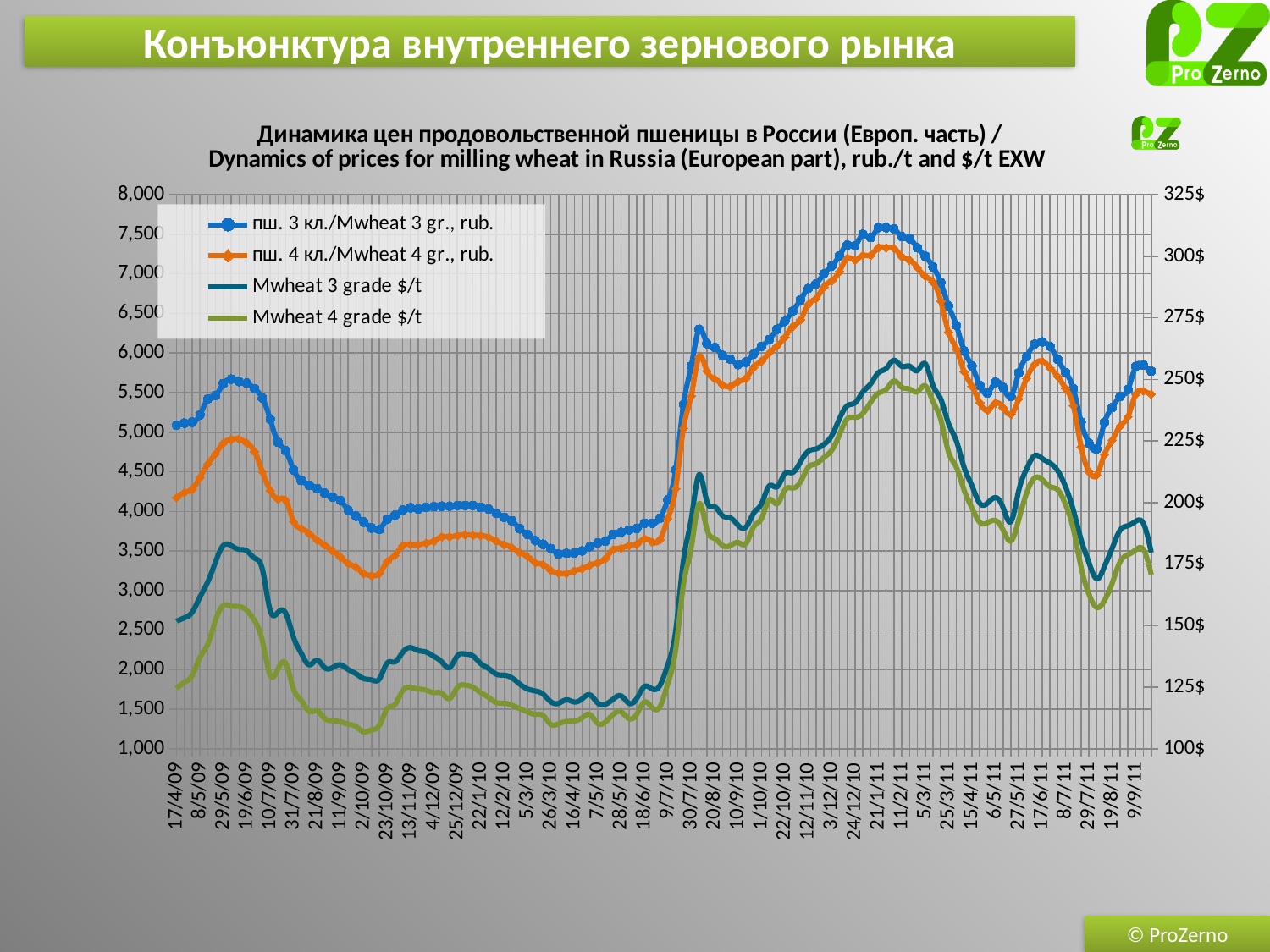
Is the value of Mwheat 4 grade $/t at 2/10/09 greater or less than 125$? less What kind of chart is shown on the slide? line chart Is the value of пш. 3 кл./Mwheat 3 gr., rub. at 2/10/09 greater or less than 4,000? less Is the value of пш. 4 кл./Mwheat 4 gr., rub. at 26/3/10 greater or less than 3,500? less Which series is plotted in blue according to the legend? пш. 3 кл./Mwheat 3 gr., rub. How many series does the legend list? 4 Do the prices of пш. 3 кл./Mwheat 3 gr., rub. rise or fall between 9/7/10 and 30/7/10? rise What is the highest value shown on the right-hand ($) axis? 325$ At 21/1/11, which is higher: пш. 3 кл./Mwheat 3 gr., rub. or пш. 4 кл./Mwheat 4 gr., rub.? пш. 3 кл./Mwheat 3 gr., rub. Do the prices of пш. 4 кл./Mwheat 4 gr., rub. rise or fall between 21/1/11 and 6/5/11? fall